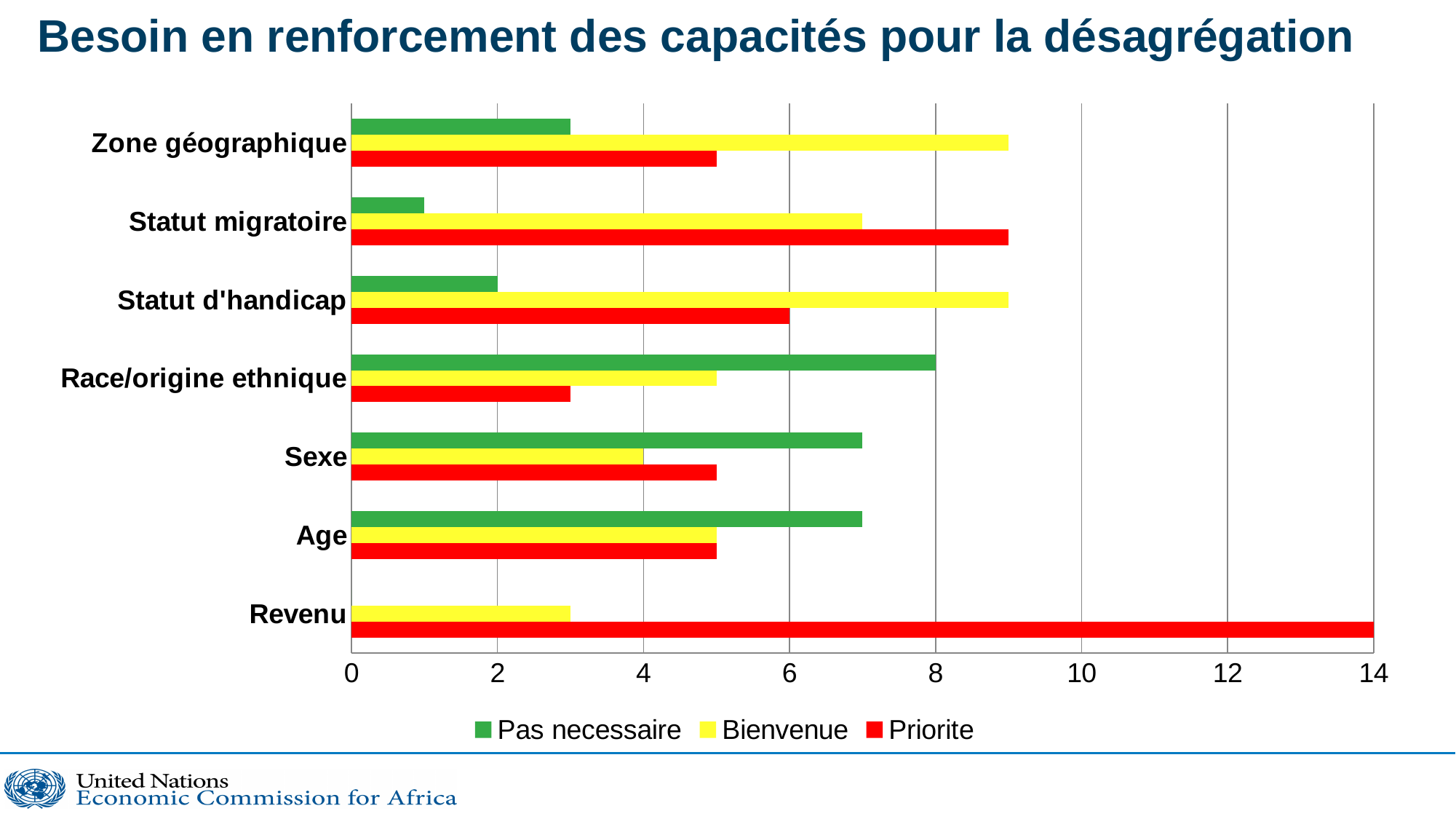
Which series is shown in red in the legend? Priorite Which category has the highest Priorite value? Revenu Which category has the lowest Pas necessaire value among those with a green bar? Statut migratoire How many series does the legend list? 3 What is the Pas necessaire value for Race/origine ethnique? 8 What is the Priorite value for Revenu? 14 Is the Bienvenue value for Zone géographique greater or less than 8? greater How many categories are shown on the vertical axis? 7 What is the Priorite value for Statut d'handicap? 6 What kind of chart is shown on the slide? bar chart Which is larger for Statut migratoire: the Priorite value or the Bienvenue value? Priorite What is the Bienvenue value for Sexe? 4